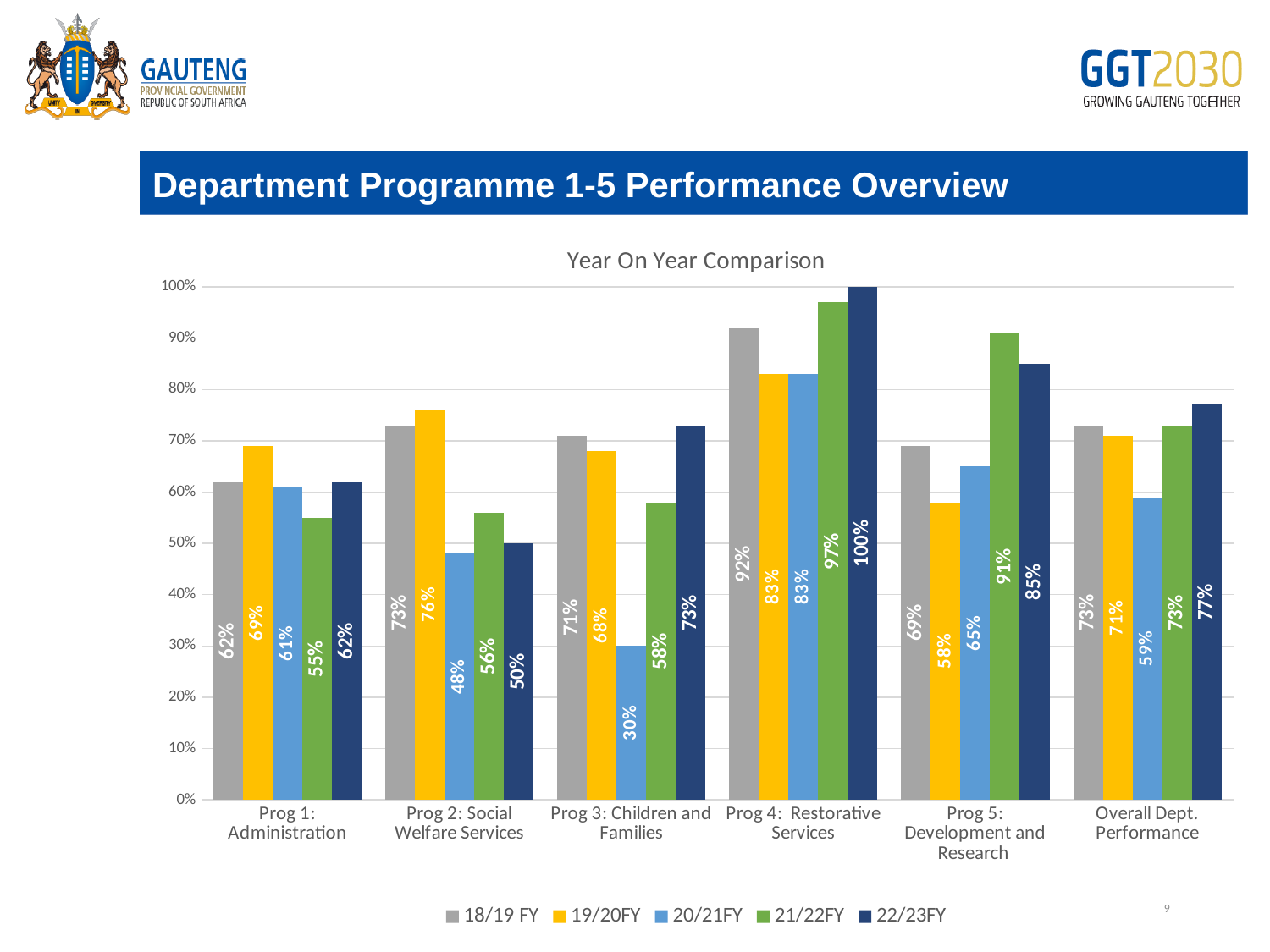
Which is larger for Prog 2: Social Welfare Services, the 19/20FY value or the 22/23FY value? 19/20FY What is the Overall Dept. Performance value for 18/19 FY? 73% What is the value for 22/23FY in Prog 4: Restorative Services? 100% What is the title of the chart? Year On Year Comparison What is the difference between the 22/23FY and 20/21FY values for Prog 3: Children and Families? 43% What is the value for 20/21FY in Prog 3: Children and Families? 30% What kind of chart is shown? Bar chart What is the value for 21/22FY in Prog 5: Development and Research? 91% Which category has the lowest value for 20/21FY? Prog 3: Children and Families How many series does the legend list? 5 Which category has the highest value for 22/23FY? Prog 4: Restorative Services How many categories are shown on the x axis? 6